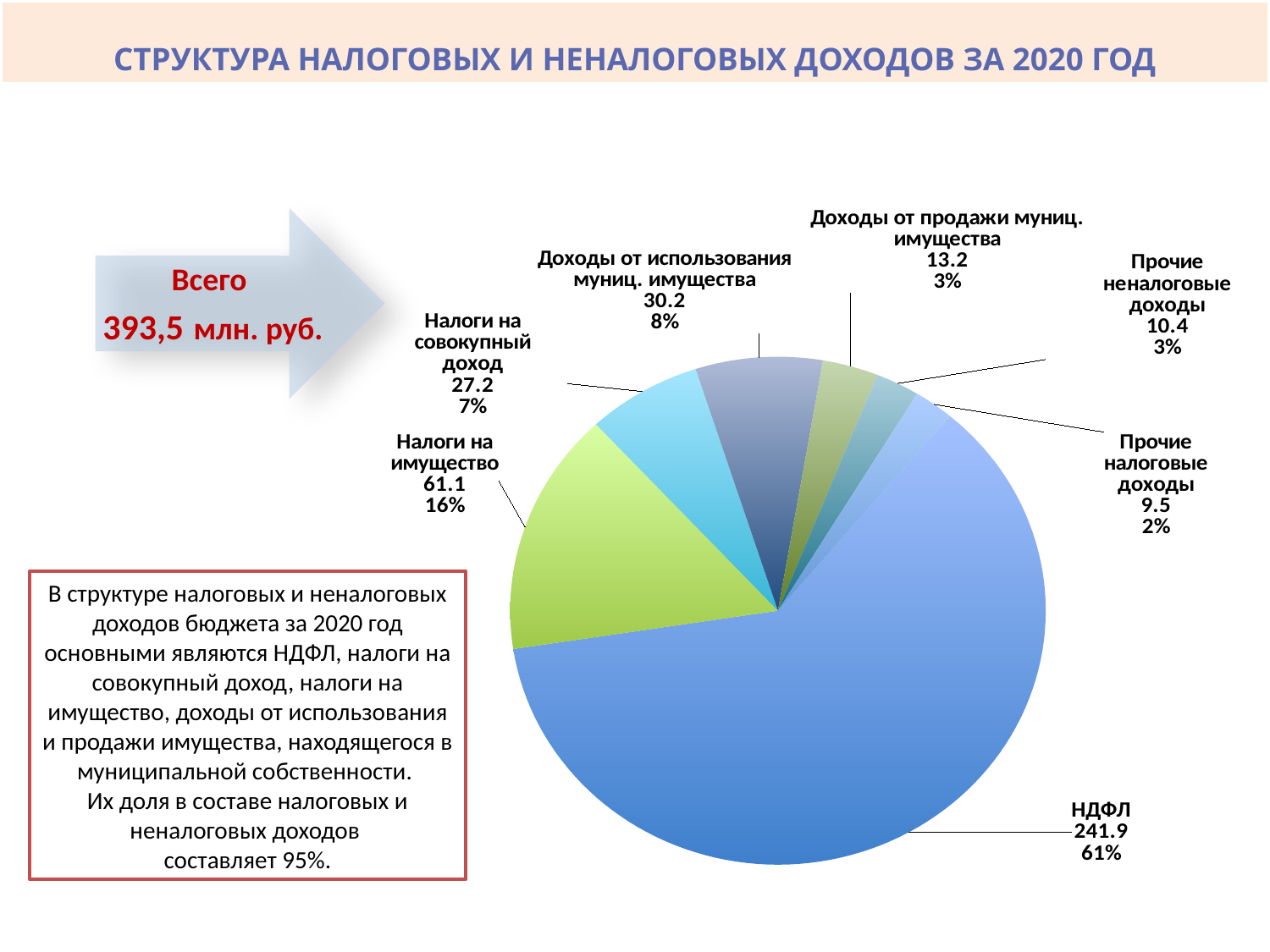
What total amount is shown in the arrow next to the chart? 393,5 млн. руб. What share of the pie does НДФЛ represent? 61% What is the difference between the values for Налоги на имущество and Налоги на совокупный доход? 33.9 What is the value for НДФЛ? 241.9 Which category has the smallest slice of the pie? Прочие налоговые доходы Which is larger, the value for Доходы от продажи муниц. имущества or Прочие неналоговые доходы? Доходы от продажи муниц. имущества Which category has the largest slice of the pie? НДФЛ How many slices does the pie chart have? 7 What is the value for Налоги на имущество? 61.1 What type of chart is shown on the slide? Pie chart What percentage is shown for Доходы от использования муниц. имущества? 8% What is the value for Прочие налоговые доходы? 9.5